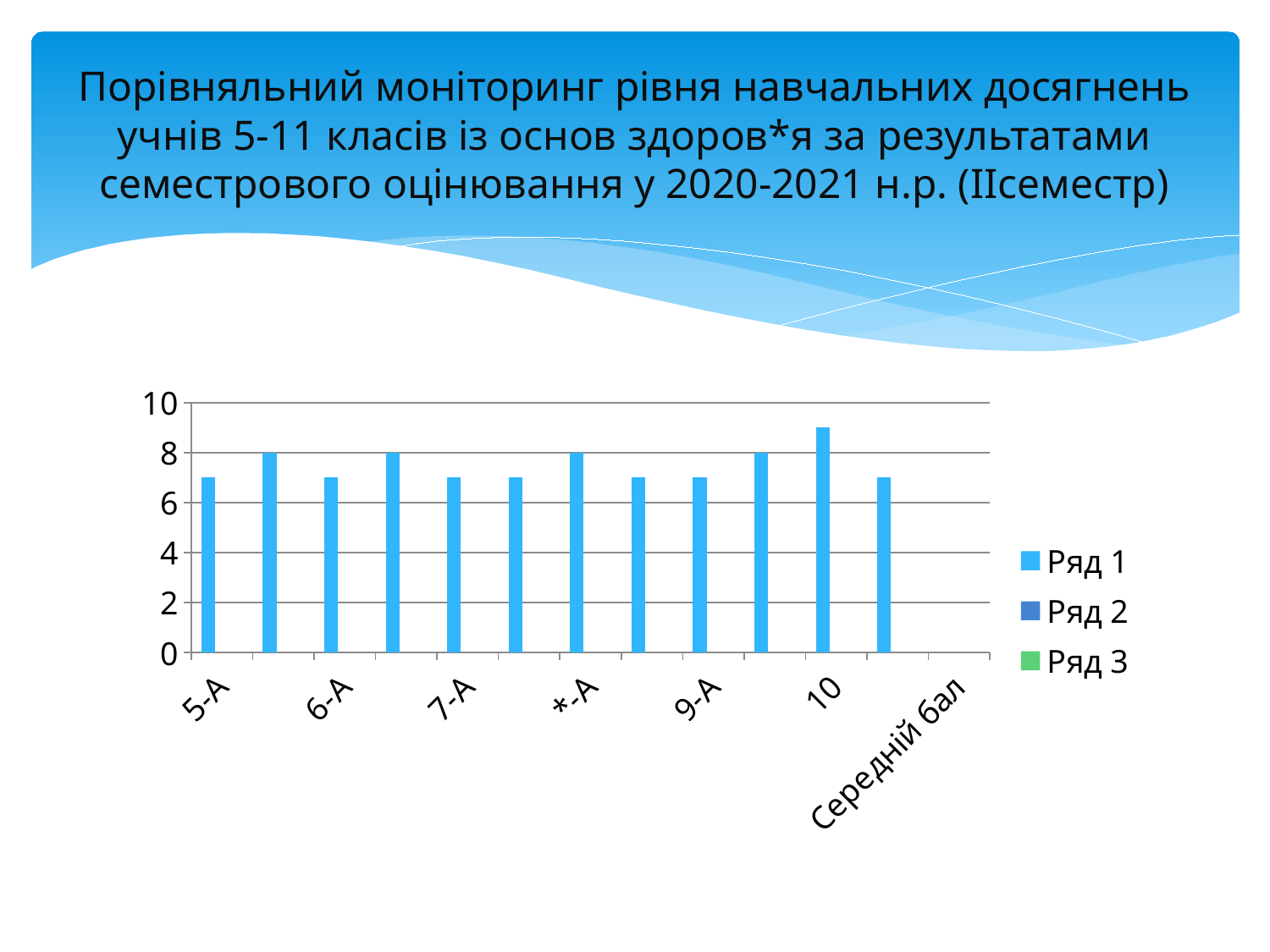
How many series does the legend list? 3 Which is larger, the value for *-А or the value for 9-А? *-А Is the value for 9-А greater or less than 8? less What is the maximum value shown on the vertical axis? 10 Is the value for 10 greater or less than 8? greater What are the entries listed in the legend? Ряд 1, Ряд 2, Ряд 3 Which is larger, the value for 10 or the value for 5-А? 10 Is the value for 6-А greater or less than 8? less What kind of chart is shown on the slide? bar chart Which category has the highest bar? 10 What is the value for *-А? 8